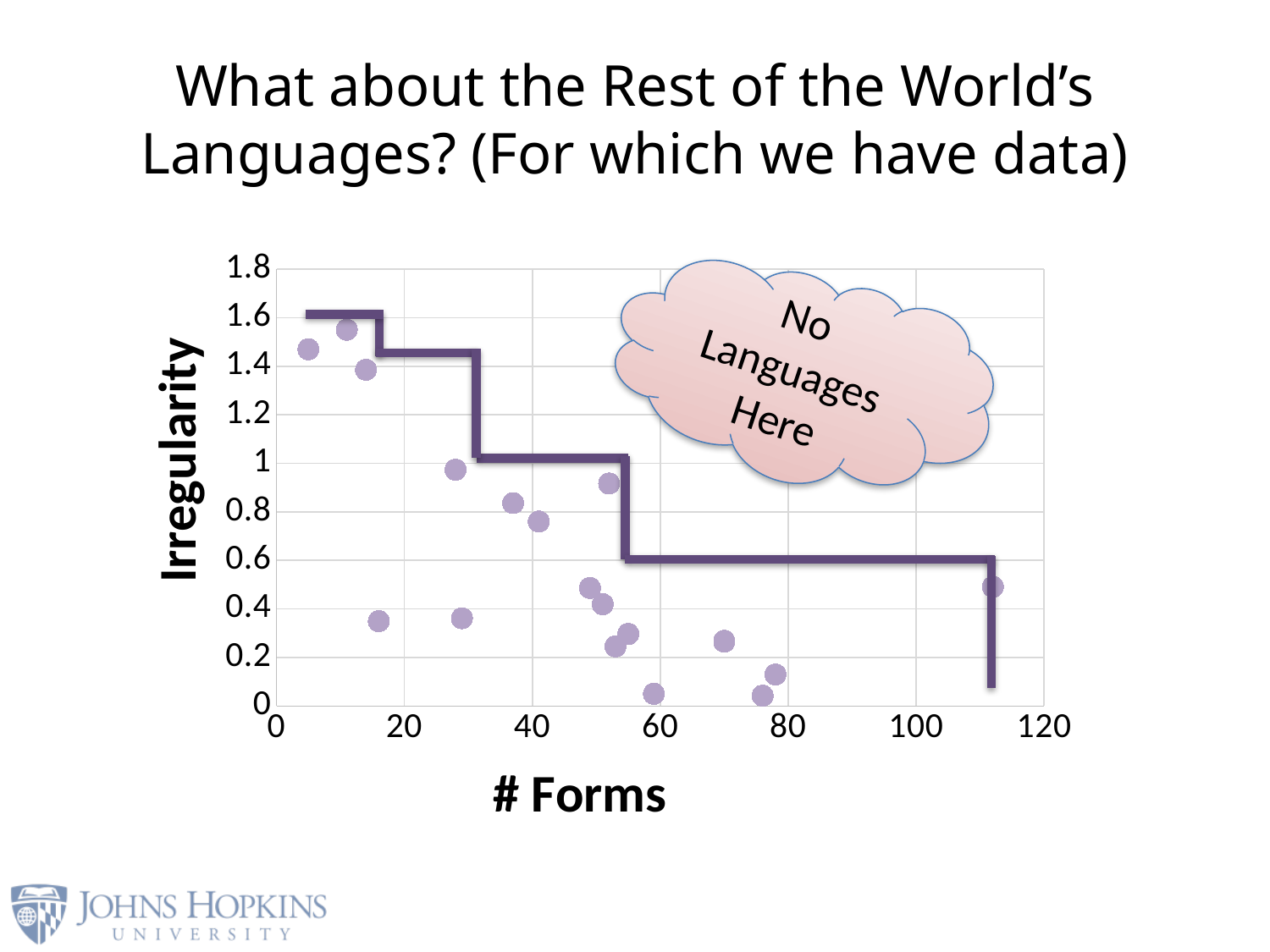
Is the Irregularity value of the point with the largest # Forms greater or less than 0.4? greater Is the # Forms value of the point with the largest # Forms greater or less than 100? greater Is the lowest Irregularity value plotted greater or less than 0.2? less What kind of chart is shown on the slide? scatter chart What is the label of the y axis of the chart? Irregularity Overall, does Irregularity tend to rise or fall as # Forms increases? fall What is the label of the x axis of the chart? # Forms